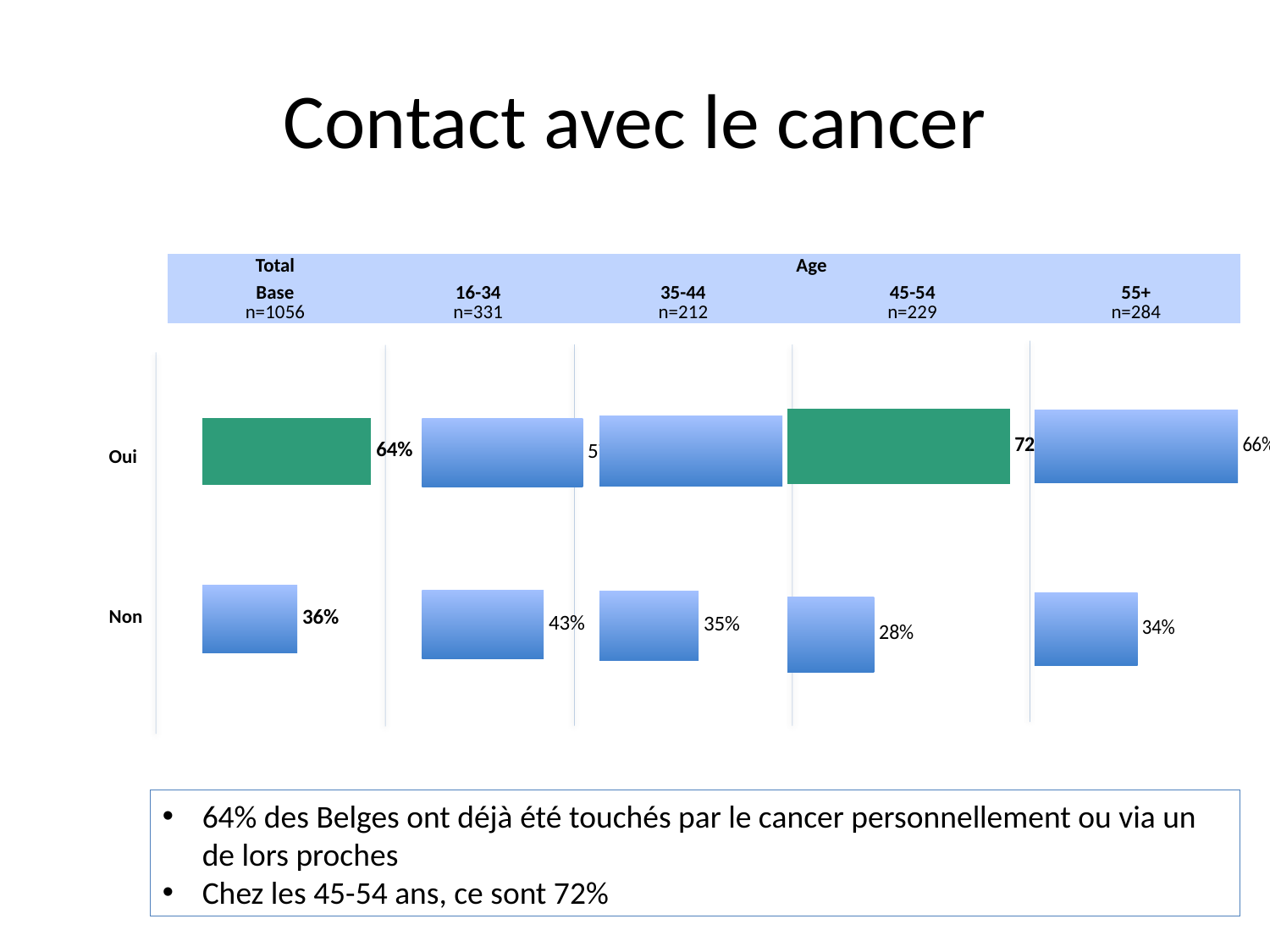
What is the "Non" value for the 35-44 age group? 35% How many age groups are shown in the chart? 4 What is the "Non" value for the 16-34 age group? 43% What is the difference between the "Oui" and "Non" values for the Total base? 28 percentage points What is the "Non" value for the 45-54 age group? 28% Which age group has the highest "Non" value? 16-34 What is the "Non" value for the 55+ age group? 34% Which has a larger "Non" value, the 16-34 group or the 55+ group? 16-34 What kind of chart is used on this slide? Bar chart What percentage of the Total base answered "Non"? 36% Which age group has the lowest "Non" value? 45-54 What percentage of the Total base answered "Oui"? 64%